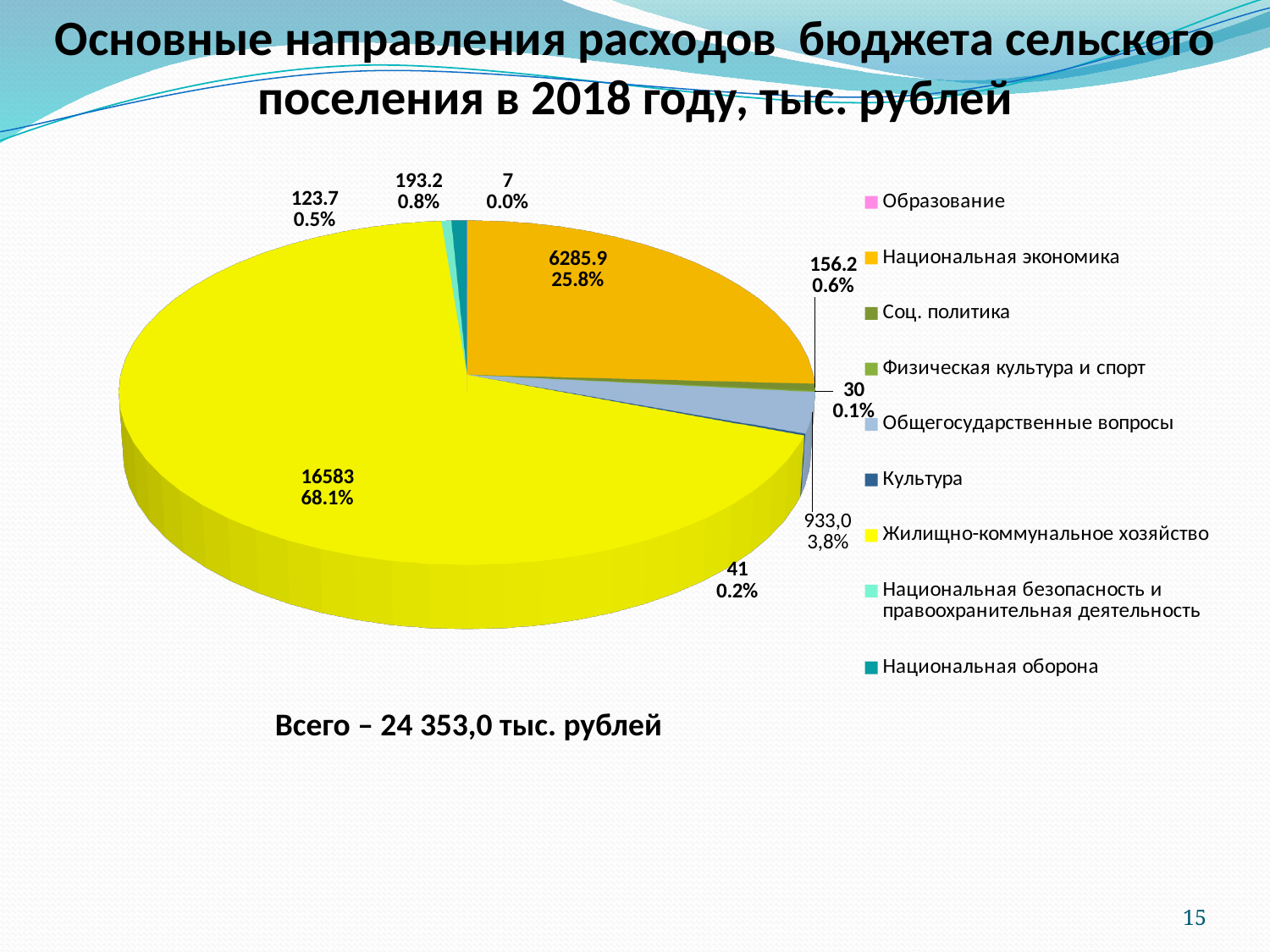
Which category has the smallest value in the pie chart? Образование What total expenditure is stated below the pie chart? 24 353,0 тыс. рублей How many categories does the legend of the pie chart list? 9 What value is shown for Национальная экономика? 6285.9 What share of the pie does Жилищно-коммунальное хозяйство take? 68.1% What value is shown for Жилищно-коммунальное хозяйство? 16583 Which is larger, the value for Жилищно-коммунальное хозяйство or the value for Национальная экономика? Жилищно-коммунальное хозяйство What is the difference between the values for Жилищно-коммунальное хозяйство and Национальная экономика? 10297.1 What kind of chart is shown on the slide? pie chart What share of the pie does Общегосударственные вопросы take? 3,8% What share of the pie does Национальная экономика take? 25.8% Which category has the largest slice of the pie chart? Жилищно-коммунальное хозяйство